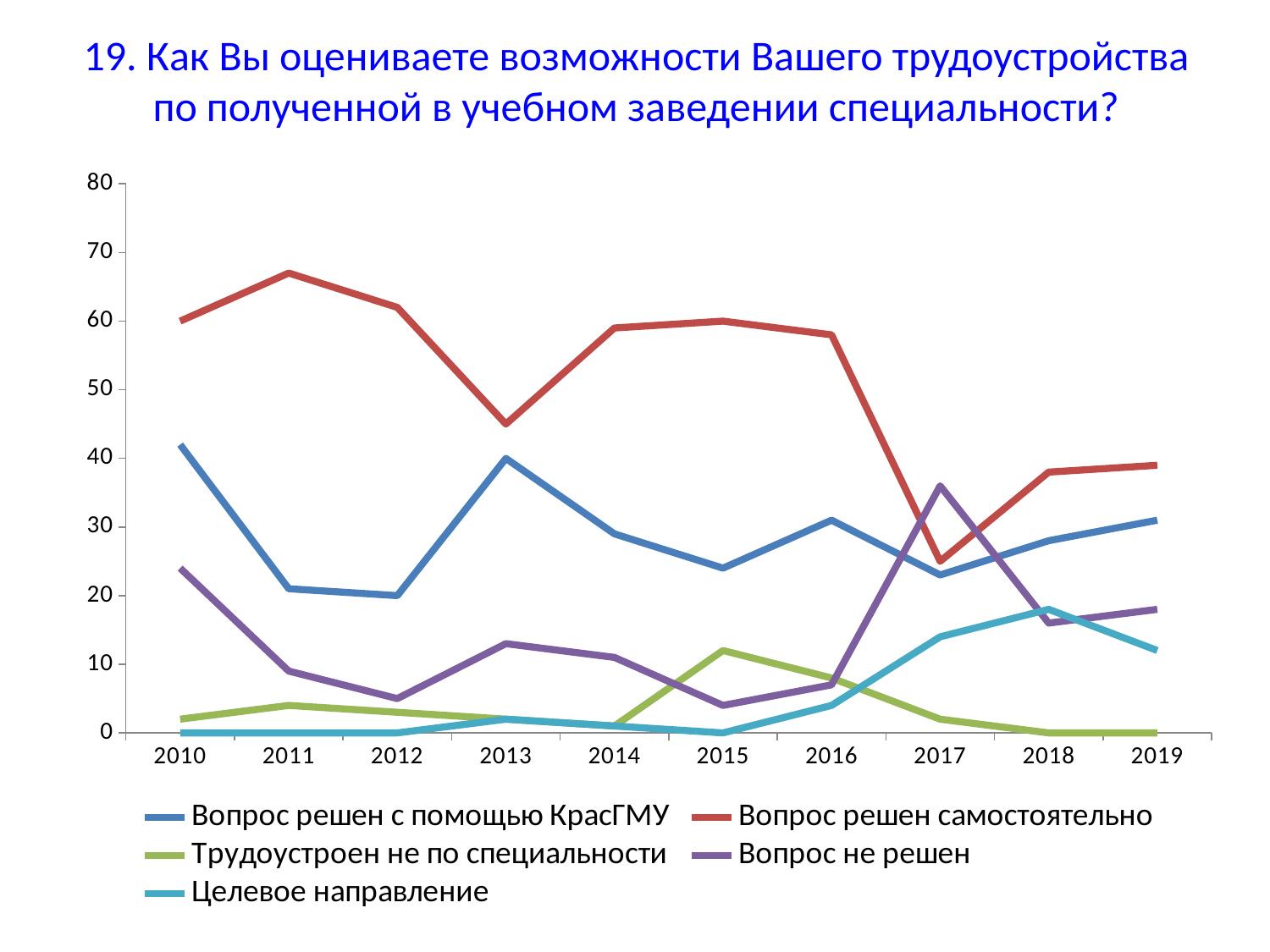
Is the value for "Вопрос не решен" in 2017 greater or less than 30? greater How many years are shown along the x axis? 10 What kind of chart is shown on the slide? line chart Does the value for "Трудоустроен не по специальности" rise or fall from 2015 to 2019? fall In 2010, which is higher: "Вопрос решен самостоятельно" or "Вопрос решен с помощью КрасГМУ"? Вопрос решен самостоятельно In 2017, which is higher: "Вопрос не решен" or "Вопрос решен самостоятельно"? Вопрос не решен Is the value for "Вопрос решен самостоятельно" in 2011 greater or less than 60? greater In which year is the value for "Вопрос решен самостоятельно" highest? 2011 In which year is the value for "Трудоустроен не по специальности" highest? 2015 In which year is the value for "Вопрос решен самостоятельно" lowest? 2017 How many series does the legend list? 5 In which year is the value for "Вопрос не решен" highest? 2017